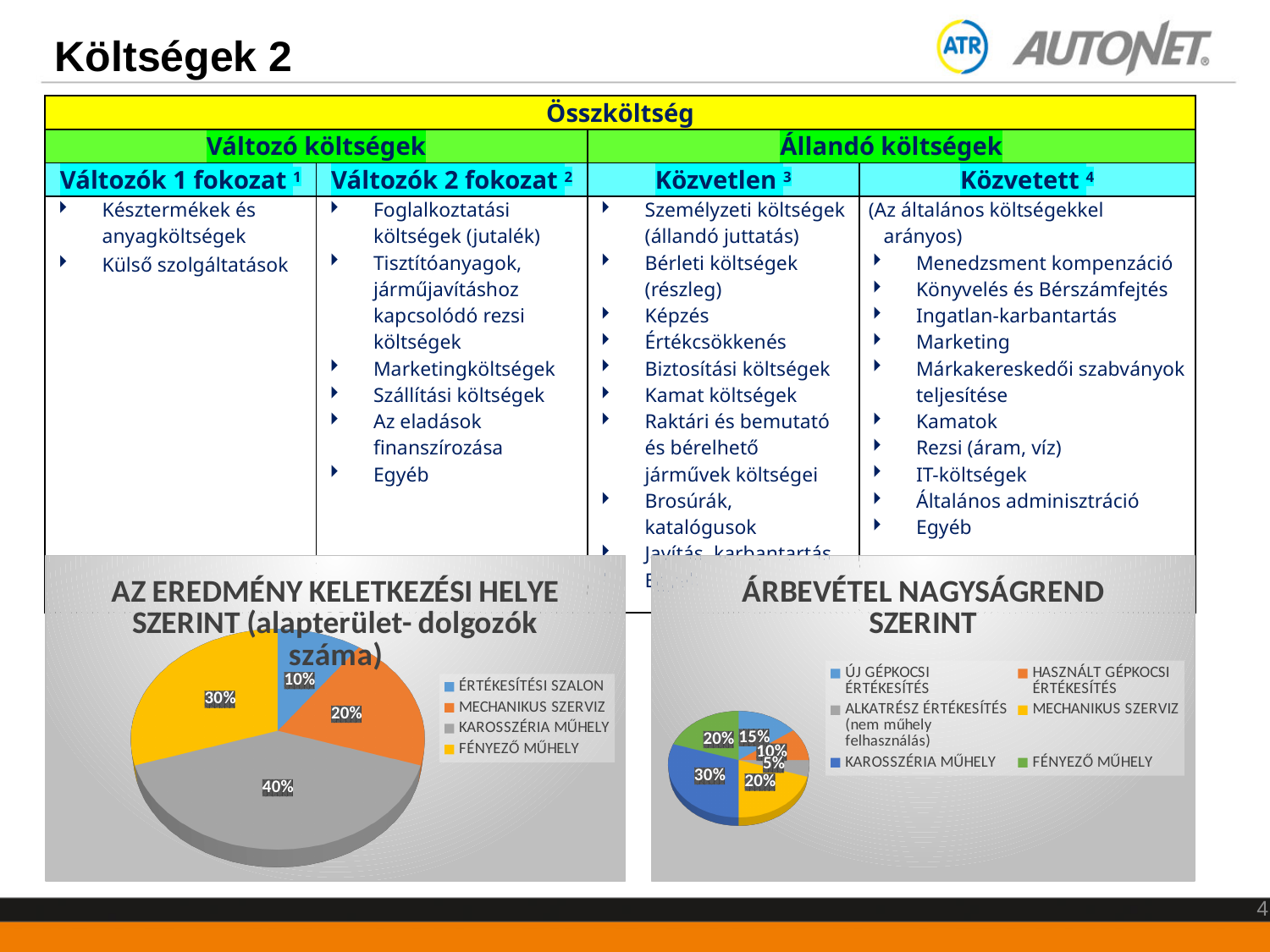
In the left pie chart (AZ EREDMÉNY KELETKEZÉSI HELYE SZERINT), which category has the largest share? KAROSSZÉRIA MŰHELY In the left pie chart (AZ EREDMÉNY KELETKEZÉSI HELYE SZERINT), what is the difference in percentage points between KAROSSZÉRIA MŰHELY and MECHANIKUS SZERVIZ? 20 percentage points In the right pie chart (ÁRBEVÉTEL NAGYSÁGREND SZERINT), what is the smallest share shown? 5% In the right pie chart (ÁRBEVÉTEL NAGYSÁGREND SZERINT), what is the largest share shown? 30% In the left pie chart (AZ EREDMÉNY KELETKEZÉSI HELYE SZERINT), what share does FÉNYEZŐ MŰHELY have? 30% What type of chart is the left chart (AZ EREDMÉNY KELETKEZÉSI HELYE SZERINT)? Pie chart In the left pie chart (AZ EREDMÉNY KELETKEZÉSI HELYE SZERINT), how many categories does the legend list? 4 In the left pie chart (AZ EREDMÉNY KELETKEZÉSI HELYE SZERINT), which category has the smallest share? ÉRTÉKESÍTÉSI SZALON In the left pie chart (AZ EREDMÉNY KELETKEZÉSI HELYE SZERINT), what share does KAROSSZÉRIA MŰHELY have? 40% In the left pie chart (AZ EREDMÉNY KELETKEZÉSI HELYE SZERINT), which colour represents FÉNYEZŐ MŰHELY? Yellow In the right pie chart (ÁRBEVÉTEL NAGYSÁGREND SZERINT), how many categories does the legend list? 6 In the left pie chart (AZ EREDMÉNY KELETKEZÉSI HELYE SZERINT), what share does ÉRTÉKESÍTÉSI SZALON have? 10%